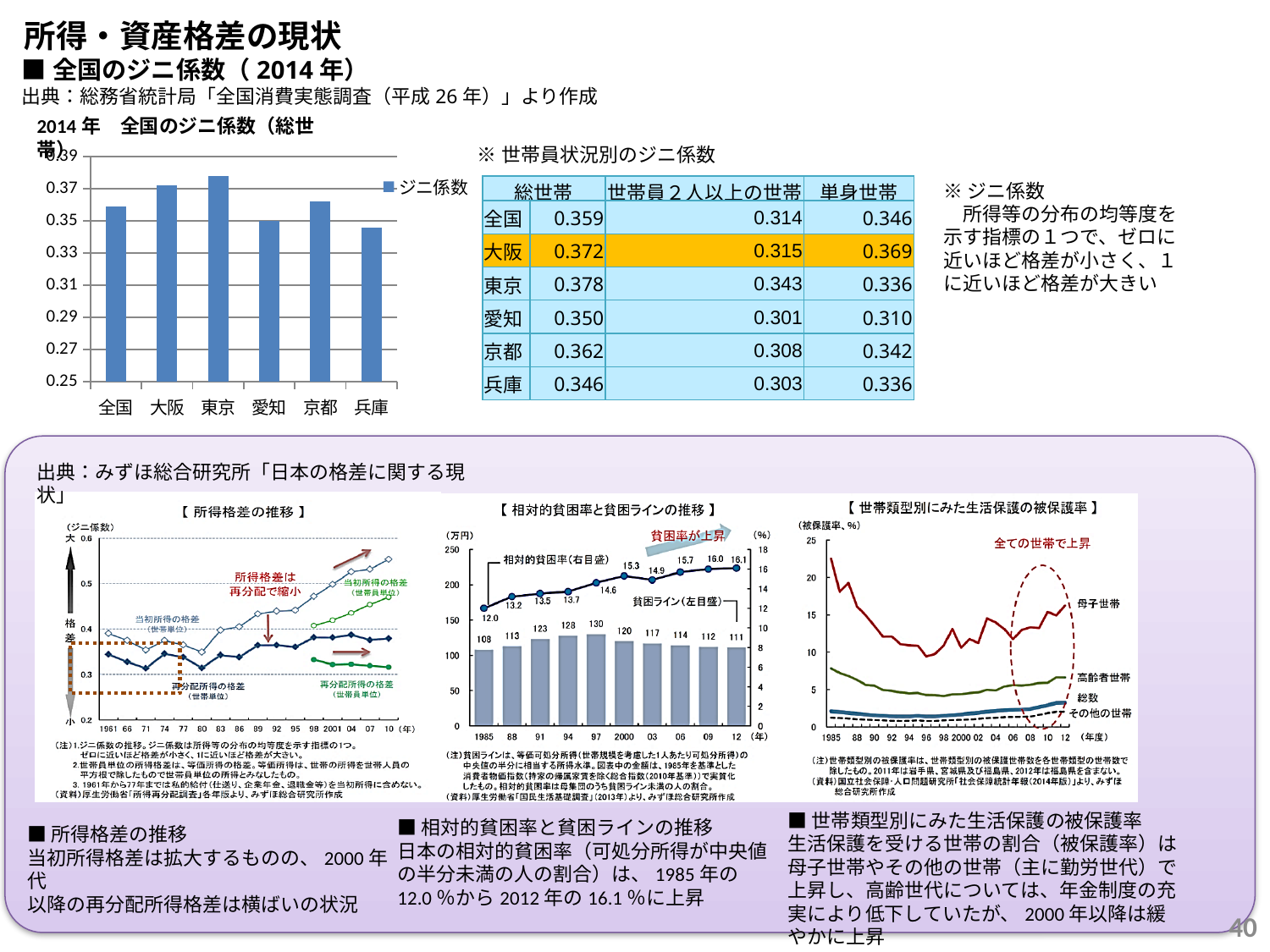
In the top-left bar chart 2014年 全国のジニ係数（総世帯）, which is larger, the bar for 大阪 or the bar for 京都? 大阪 In the top-left bar chart 2014年 全国のジニ係数（総世帯）, which category has the highest bar? 東京 In the top-left bar chart 2014年 全国のジニ係数（総世帯）, what series name does the legend show? ジニ係数 In the top-left bar chart 2014年 全国のジニ係数（総世帯）, which category has the lowest bar? 兵庫 In the top-left bar chart 2014年 全国のジニ係数（総世帯）, how many categories are shown on the x axis? 6 What kind of chart is the top-left chart titled 2014年 全国のジニ係数（総世帯）? bar chart In the bottom-middle chart 相対的貧困率と貧困ラインの推移, what is the 相対的貧困率 value for 2012? 16.1 In the bottom-right chart 世帯類型別にみた生活保護の被保護率, which household type has the highest line? 母子世帯 In the bottom-middle chart 相対的貧困率と貧困ラインの推移, what is the 貧困ライン value for 1997? 130 In the bottom-middle chart 相対的貧困率と貧困ラインの推移, in which year is the 貧困ライン bar highest? 1997